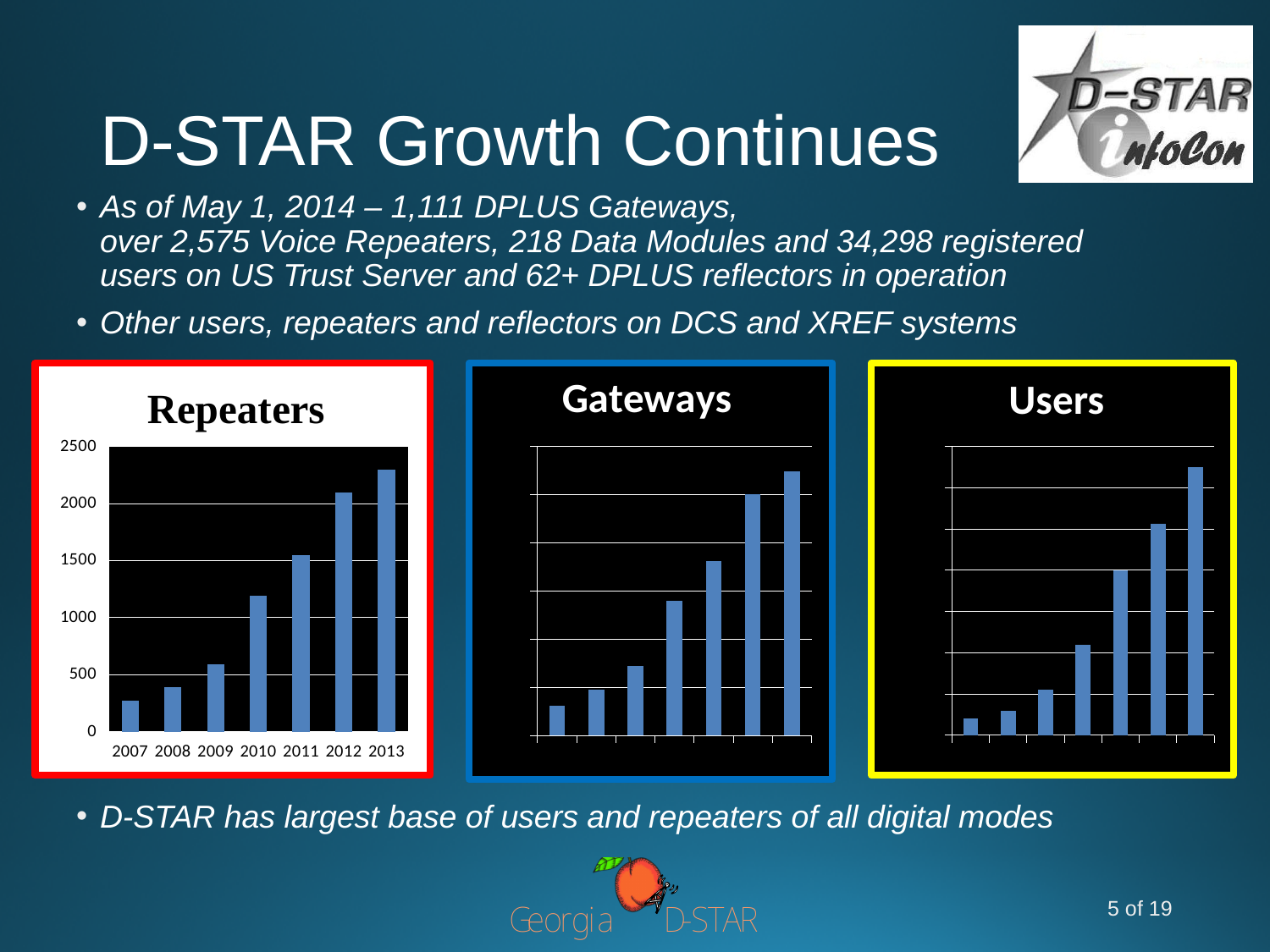
Do the values in the Repeaters chart rise or fall from 2007 to 2013? rise In the Repeaters chart, which is larger, the value for 2010 or the value for 2009? 2010 In the Repeaters chart, is the value for 2009 greater or less than 1000? less In the Repeaters chart, which year has the highest bar? 2013 In the Repeaters chart, is the value for 2012 greater or less than 2000? greater In the Repeaters chart, which year has the lowest bar? 2007 How many years are shown on the x axis of the Repeaters chart? 7 What kind of chart is the Repeaters chart? bar chart In the Repeaters chart, is the value for 2007 greater or less than 500? less How many bars are plotted in the Gateways chart? 7 What is the title of the chart on the right of the slide? Users